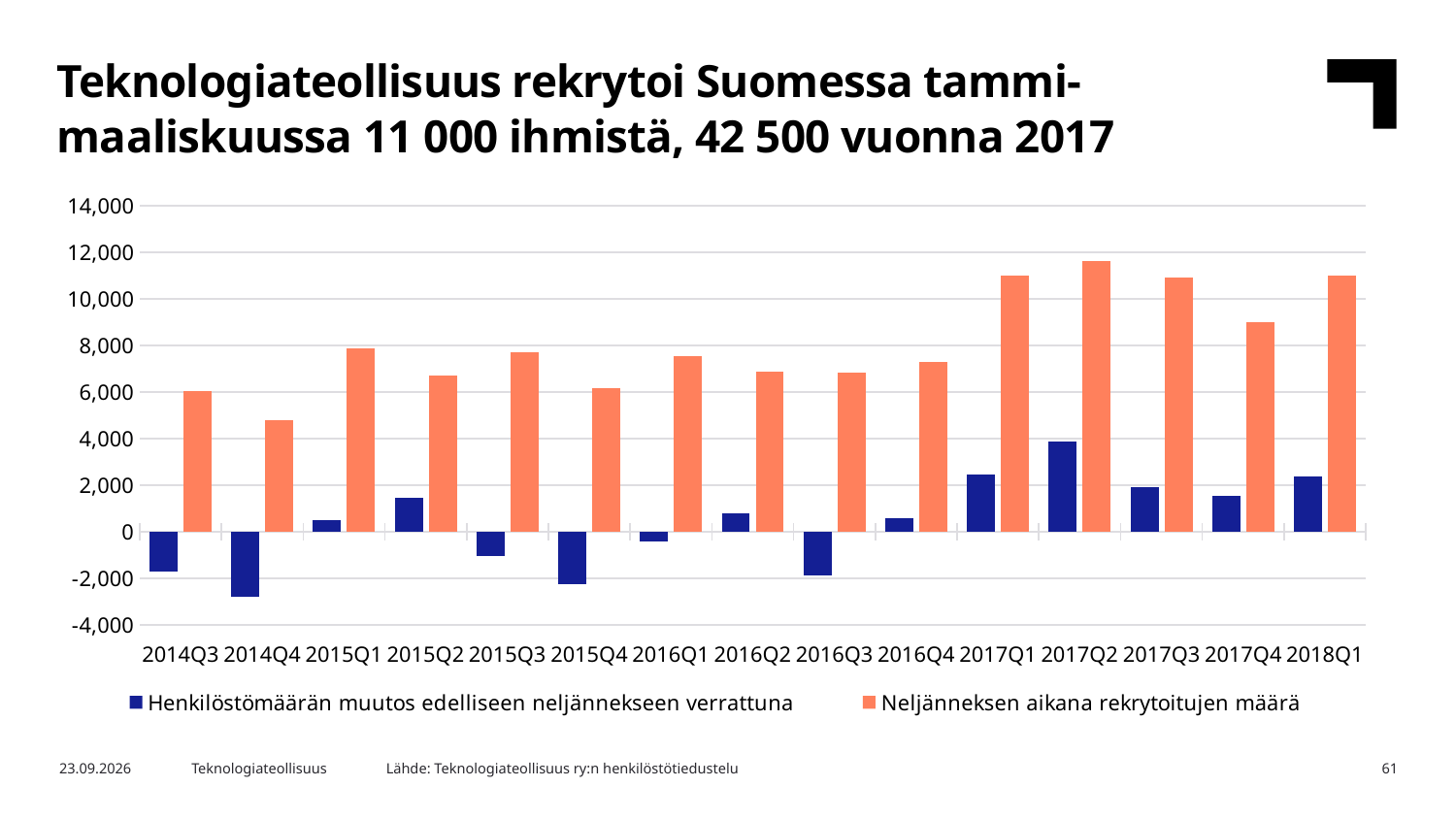
Which quarter has the highest value for Henkilöstömäärän muutos edelliseen neljännekseen verrattuna? 2017Q2 Which quarter has the lowest value for Neljänneksen aikana rekrytoitujen määrä? 2014Q4 Which quarter has the lowest value for Henkilöstömäärän muutos edelliseen neljännekseen verrattuna? 2014Q4 Which quarter has the highest value for Neljänneksen aikana rekrytoitujen määrä? 2017Q2 What kind of chart is shown on the slide? bar chart Is the value for Neljänneksen aikana rekrytoitujen määrä in 2017Q4 greater or less than 10,000? less Which series is shown in orange in the legend? Neljänneksen aikana rekrytoitujen määrä How many quarters are shown on the x axis? 15 How many series does the legend list? 2 Is the value for Neljänneksen aikana rekrytoitujen määrä in 2017Q2 greater or less than 10,000? greater Is the value for Henkilöstömäärän muutos edelliseen neljännekseen verrattuna in 2014Q4 greater or less than -2,000? less Which is larger, the Neljänneksen aikana rekrytoitujen määrä value for 2017Q1 or for 2017Q4? 2017Q1